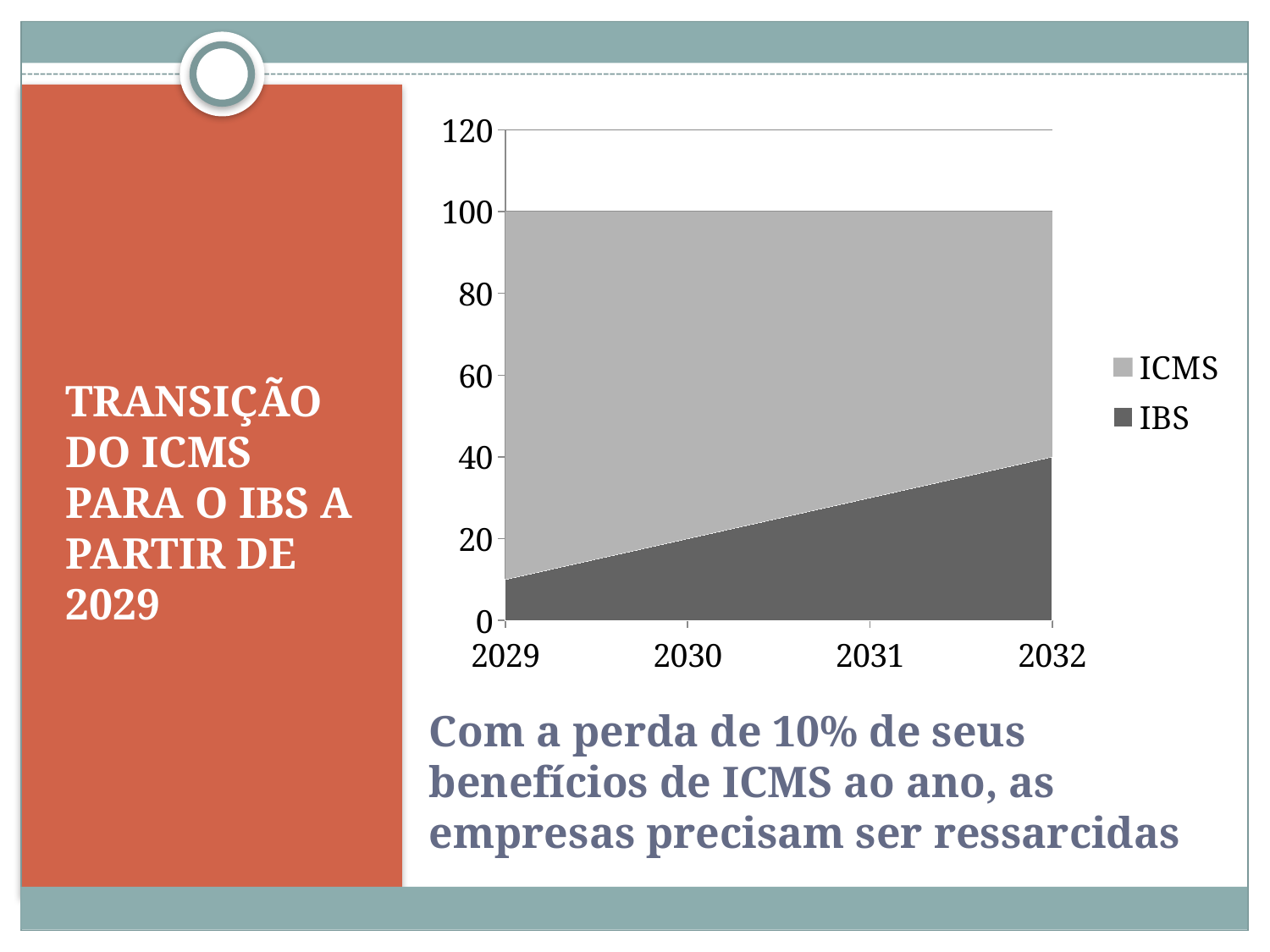
What is the combined total of ICMS and IBS in 2029? 100 What is the value of IBS in 2032? 40 What is the value of IBS in 2030? 20 Does the ICMS share of the stacked area rise or fall from 2029 to 2032? fall How many series does the chart legend list? 2 What is the first year shown on the x axis of the chart? 2029 Which series are listed in the chart legend? ICMS and IBS What kind of chart is shown on the slide? area chart Is the value for IBS in 2029 greater or less than 20? less Does the IBS series rise or fall from 2029 to 2032? rise In 2029, which is larger, ICMS or IBS? ICMS How many years are shown along the x axis of the chart? 4